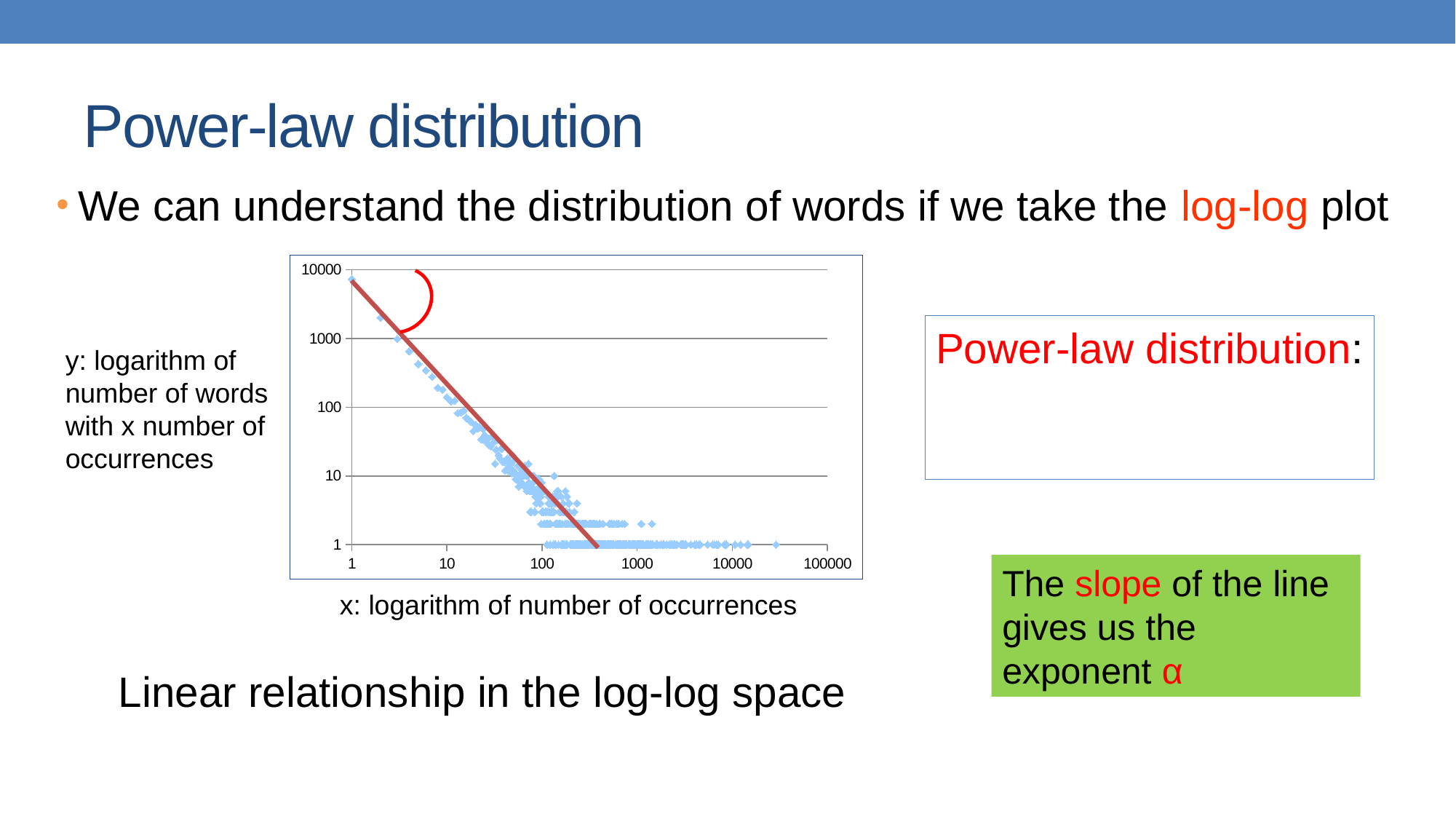
Is the y value of the points at x = 10000 greater or less than 10? less What is the label of the x axis of the chart? x: logarithm of number of occurrences Do the plotted values rise or fall as the number of occurrences increases along the x axis? fall Is the y value of the points at x = 1000 greater or less than 100? less Is the y value of the point at x = 1 greater or less than 1000? greater Which has the larger y value: the point at x = 1 or the points at x = 100? the point at x = 1 How many tick labels are shown on the x axis of the chart? 6 What is the highest tick value shown on the y axis of the chart? 10000 What kind of chart is shown on the slide? scatter plot What is the lowest y value at which plotted points appear on the chart? 1 What is the highest tick value shown on the x axis of the chart? 100000